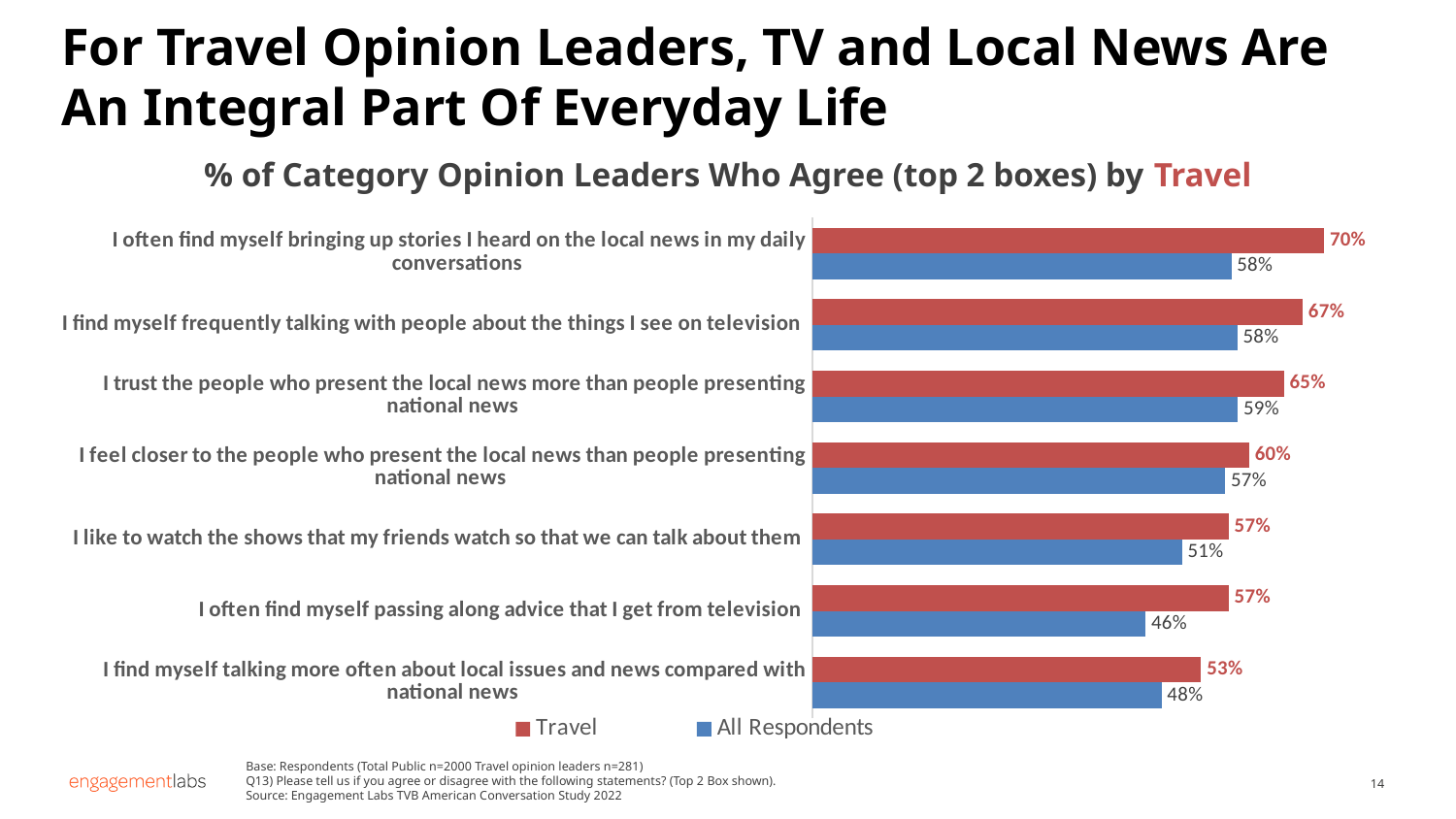
How many series does the legend list? 2 Which is larger for "I trust the people who present the local news more than people presenting national news": the Travel value or the All Respondents value? Travel What is the difference between the Travel and All Respondents values for "I often find myself bringing up stories I heard on the local news in my daily conversations"? 12% Which series is shown in red in the chart? Travel What is the Travel value for "I find myself talking more often about local issues and news compared with national news"? 53% What is the Travel value for "I often find myself bringing up stories I heard on the local news in my daily conversations"? 70% Which statement has the lowest All Respondents value? I often find myself passing along advice that I get from television What is the All Respondents value for "I often find myself passing along advice that I get from television"? 46% How many statements are shown in the chart? 7 What is the difference between the Travel and All Respondents values for "I often find myself passing along advice that I get from television"? 11% What kind of chart is shown on the slide? Bar chart Which statement has the highest Travel value? I often find myself bringing up stories I heard on the local news in my daily conversations